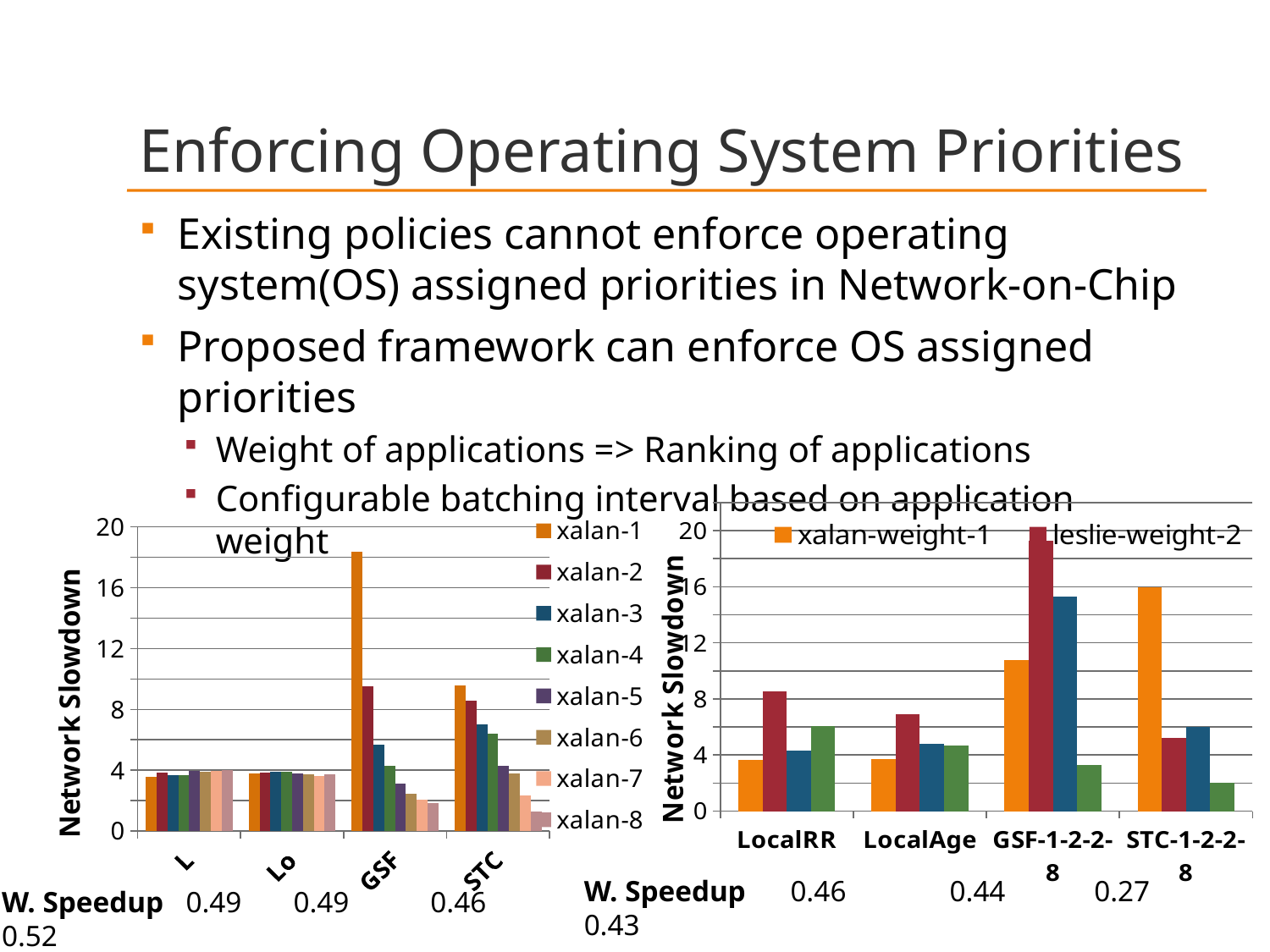
How many categories are shown on the x axis of the right chart? 4 What type of chart is the left chart on the slide? bar chart In the left chart, which category contains the tallest bar? GSF In the right chart, is the value for xalan-weight-1 in the LocalRR category greater or less than 4? less In the left chart, which is larger: xalan-1 in GSF or xalan-1 in STC? xalan-1 in GSF In the right chart, is the value for xalan-weight-1 in the GSF-1-2-2-8 category greater or less than 8? greater What is the y-axis title of the right chart? Network Slowdown In the right chart, which category has the highest xalan-weight-1 value? STC-1-2-2-8 In the left chart, is the value for xalan-1 in the GSF category greater or less than 16? greater How many series does the legend of the left chart list? 8 In the right chart, which is larger: xalan-weight-1 in GSF-1-2-2-8 or xalan-weight-1 in LocalAge? xalan-weight-1 in GSF-1-2-2-8